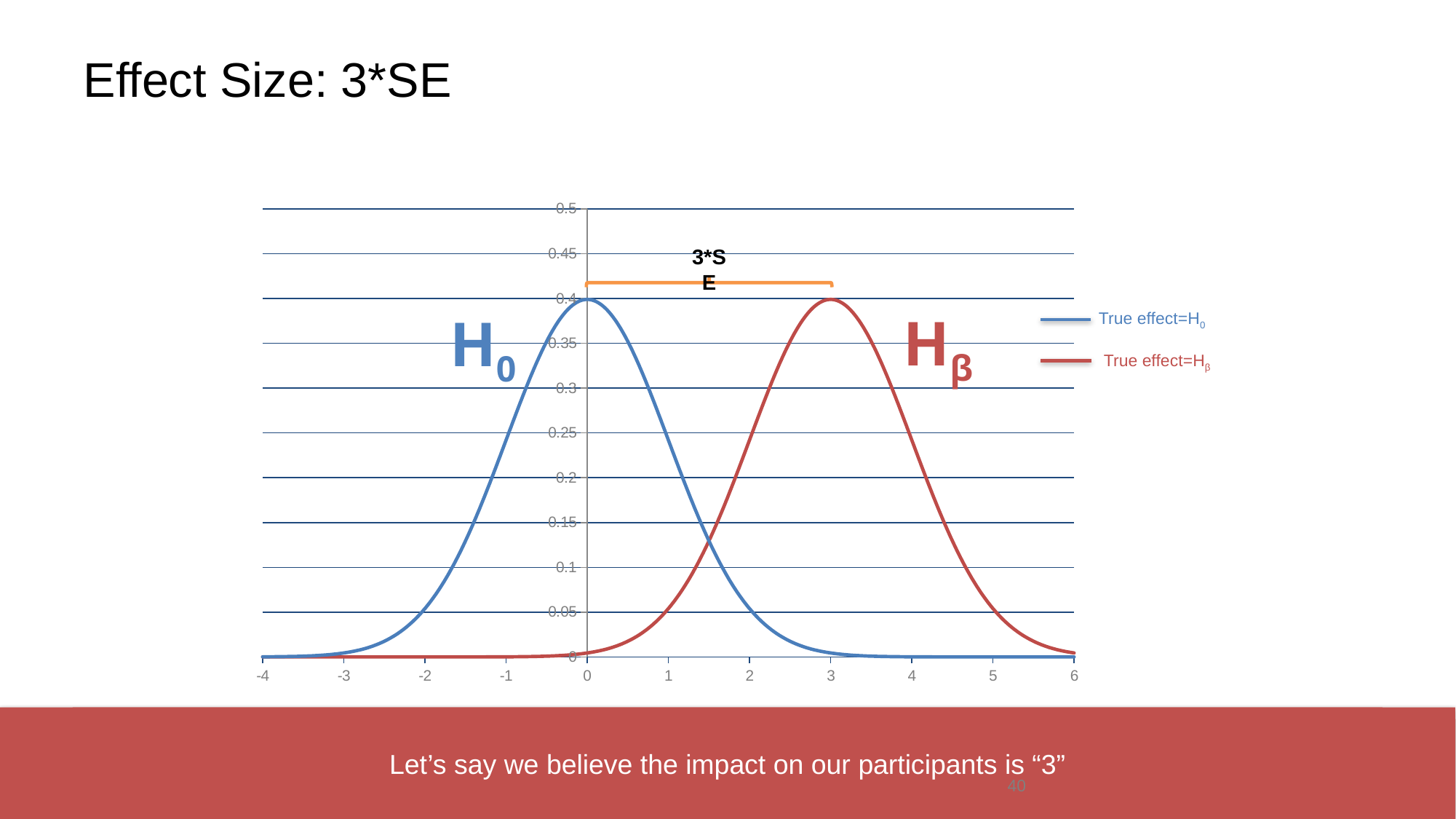
At x = 1, which curve has the higher value, 'True effect=H0' or 'True effect=Hβ'? True effect=H0 Which colour is used for the 'True effect=H0' series? blue At which x-axis value does the blue 'True effect=H0' curve reach its peak? 0 At x = 2, which curve has the higher value, 'True effect=H0' or 'True effect=Hβ'? True effect=Hβ Is the value of the blue 'True effect=H0' curve at x = 0 greater or less than 0.35? greater Does the blue 'True effect=H0' curve rise or fall as x goes from 0 to 6? fall What is the title of the slide containing the chart? Effect Size: 3*SE At which x-axis value does the red 'True effect=Hβ' curve reach its peak? 3 How many series does the legend list? 2 Is the value of the red 'True effect=Hβ' curve at x = 0 greater or less than 0.05? less What kind of chart is shown on the slide? line chart Is the value of the blue 'True effect=H0' curve at x = 3 greater or less than 0.05? less